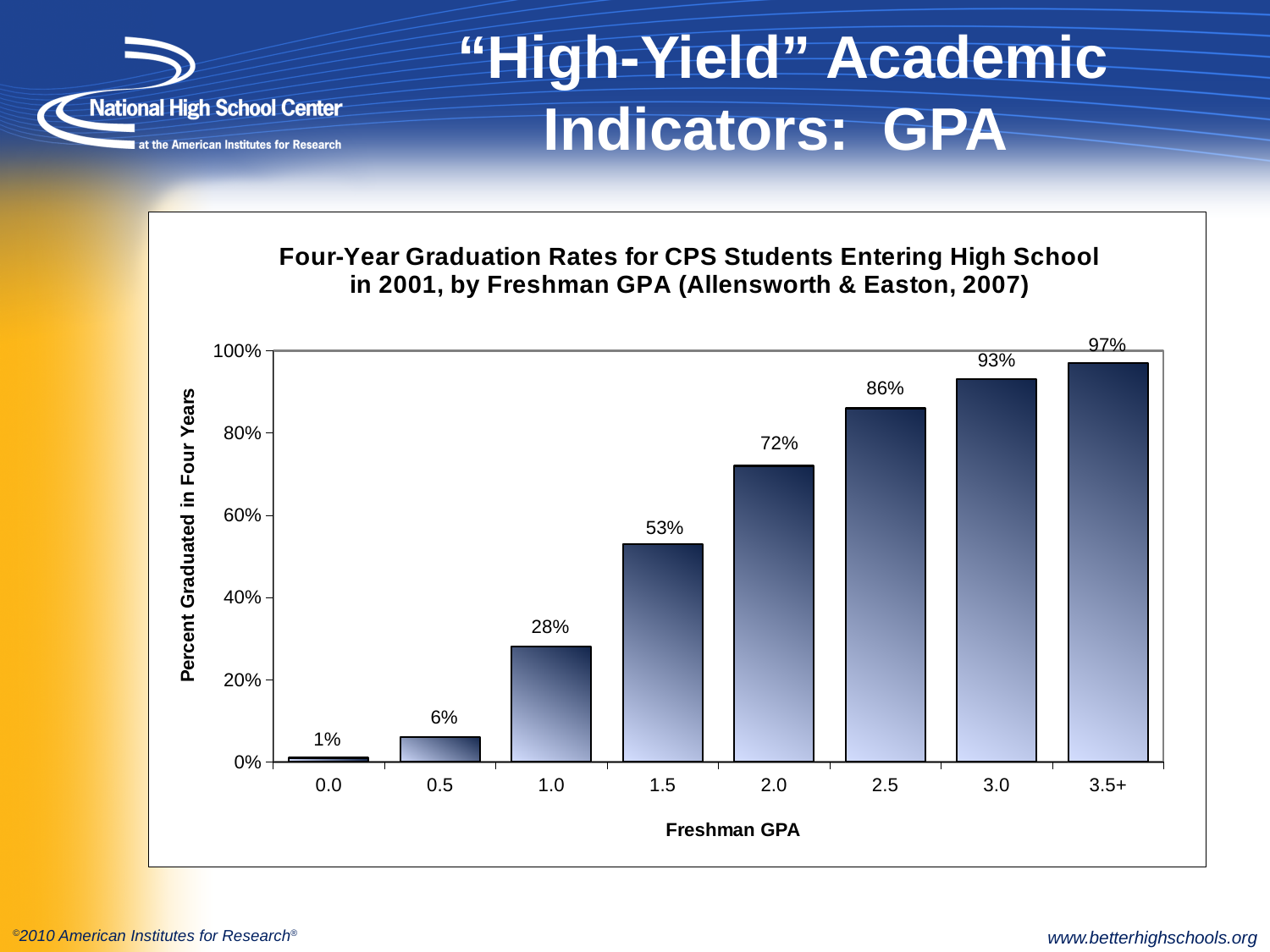
What is the difference in graduation rate between a freshman GPA of 1.5 and a freshman GPA of 1.0? 25% What is the four-year graduation rate for students with a freshman GPA of 3.5+? 97% Is the graduation rate for a freshman GPA of 1.5 greater or less than 60%? less Which freshman GPA category has the lowest four-year graduation rate? 0.0 What is the label of the y axis of the chart? Percent Graduated in Four Years What kind of chart is shown on the slide? Bar chart Which freshman GPA category has the highest four-year graduation rate? 3.5+ What is the four-year graduation rate for students with a freshman GPA of 2.0? 72% What is the four-year graduation rate for students with a freshman GPA of 0.5? 6% Do the graduation rates rise or fall as freshman GPA increases along the x axis? Rise Which has a higher graduation rate: a freshman GPA of 2.5 or a freshman GPA of 3.0? 3.0 How many freshman GPA categories are shown on the x axis? 8